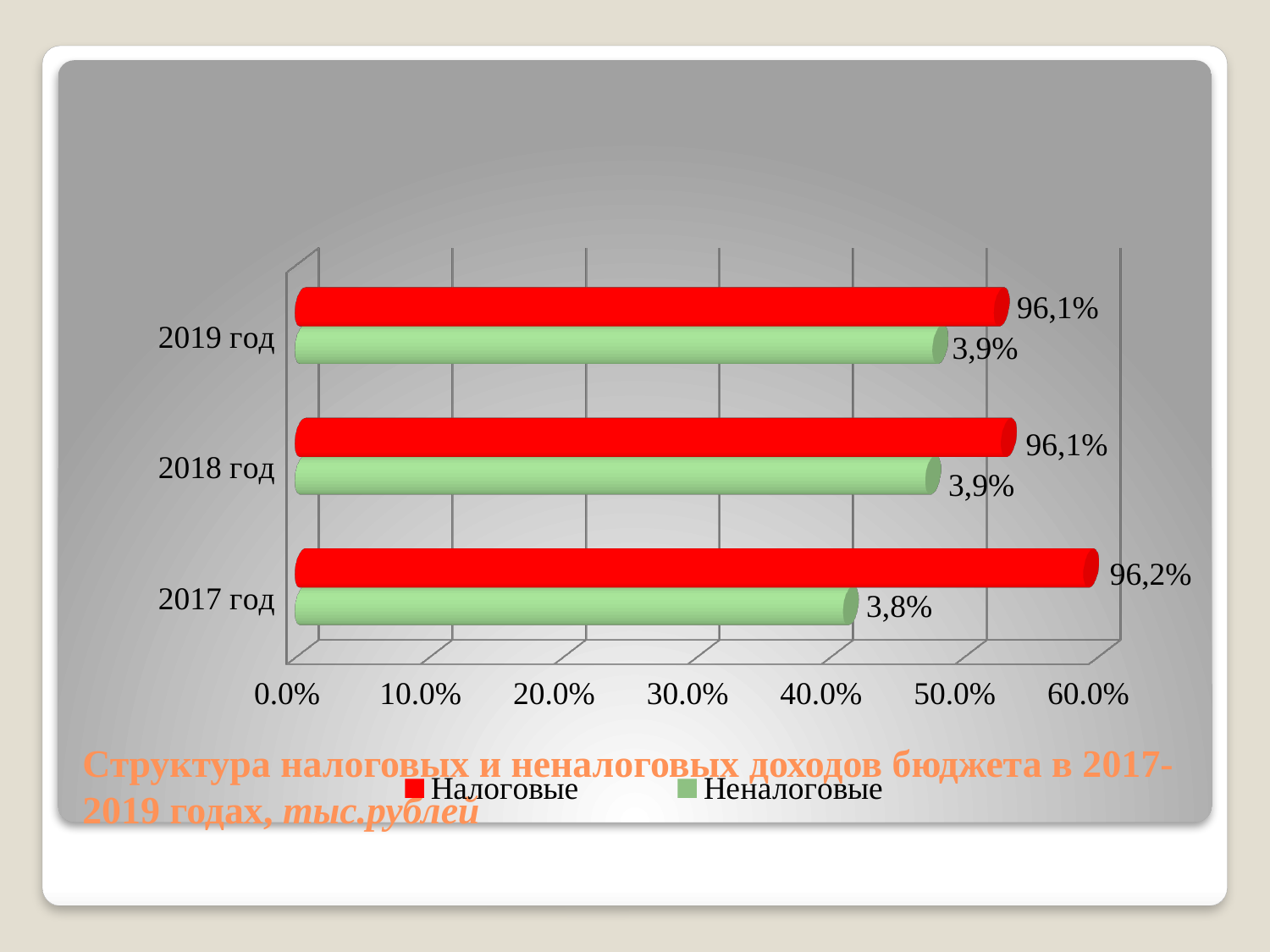
In which year is the Неналоговые value the lowest? 2017 год In which year is the Налоговые value the highest? 2017 год Which colour represents the Неналоговые series in the legend? Green What is the value for Неналоговые in 2017 год? 3,8% What is the value for Налоговые in 2017 год? 96,2% What is the value for Налоговые in 2018 год? 96,1% What kind of chart is shown on the slide? Bar chart Which is larger in 2018 год, Налоговые or Неналоговые? Налоговые How many series does the legend list? 2 How many years (categories) are shown on the chart? 3 What is the difference between the Налоговые and Неналоговые values in 2017 год? 92,4% What is the value for Неналоговые in 2019 год? 3,9%